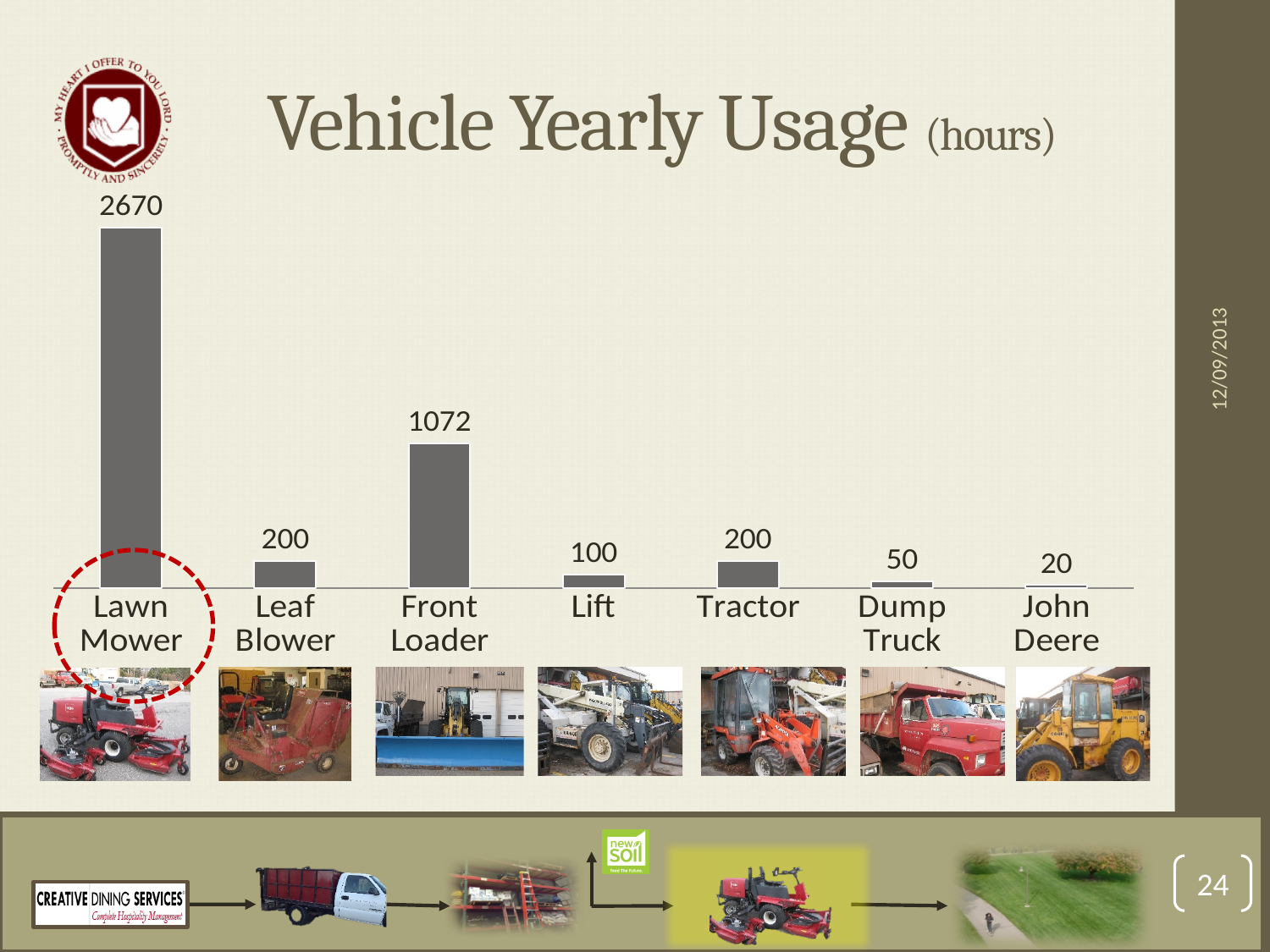
What is the difference in yearly usage hours between the Lawn Mower and the Front Loader? 1598 What is the title of the chart? Vehicle Yearly Usage (hours) What kind of chart is shown on the slide? Bar chart Which vehicle has the highest yearly usage? Lawn Mower What is the difference in yearly usage hours between the Lift and the Dump Truck? 50 Which vehicle has the lowest yearly usage? John Deere What is the yearly usage in hours for the Lawn Mower? 2670 What is the yearly usage in hours for the John Deere? 20 What is the yearly usage in hours for the Dump Truck? 50 Which has higher yearly usage, the Leaf Blower or the Lift? Leaf Blower What is the yearly usage in hours for the Front Loader? 1072 How many vehicles are shown in the chart? 7